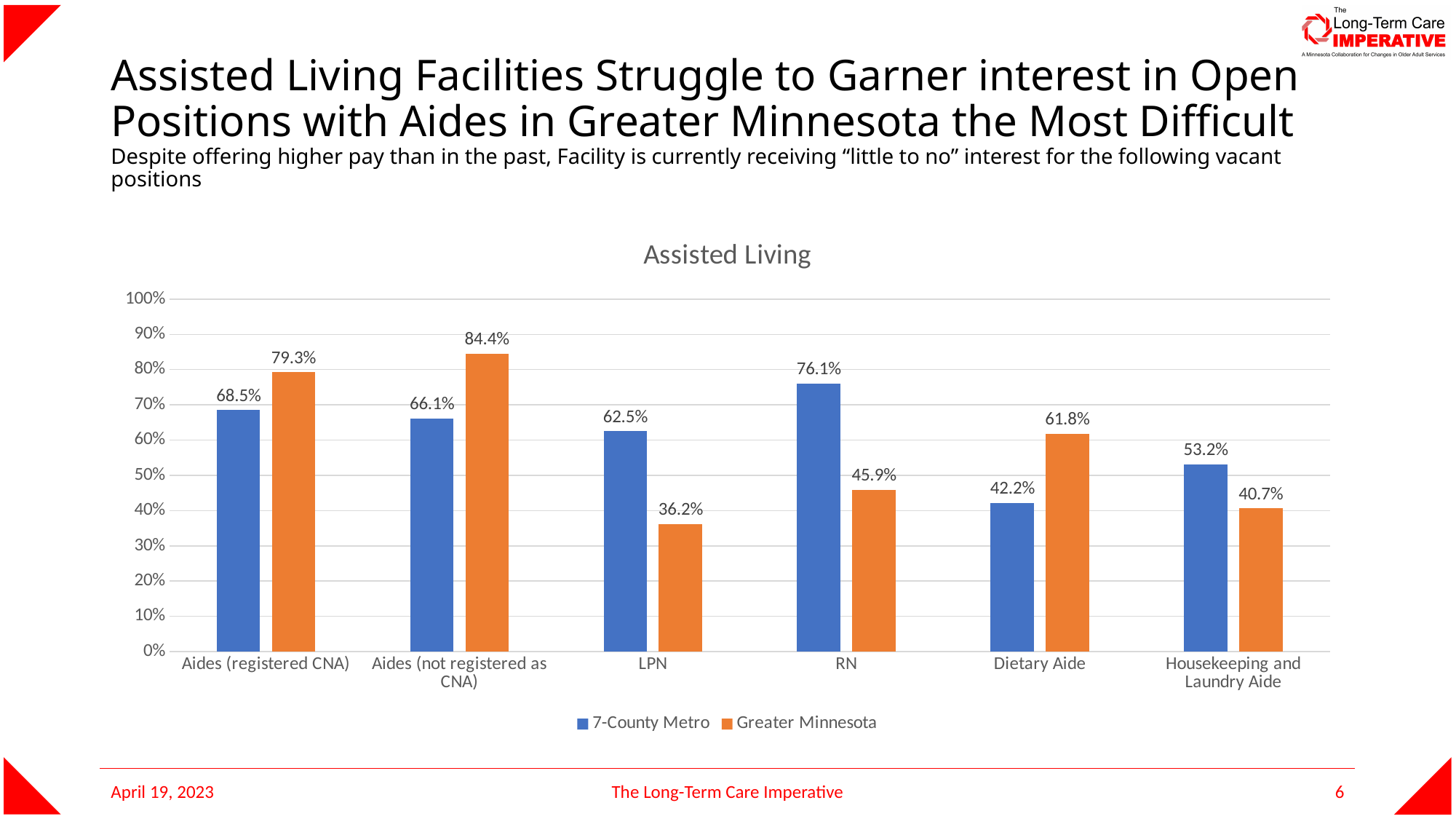
What is the Greater Minnesota value for Housekeeping and Laundry Aide? 40.7% Which category has the highest Greater Minnesota value? Aides (not registered as CNA) Which category has the lowest 7-County Metro value? Dietary Aide How many series does the legend list? 2 What is the title of the chart? Assisted Living How many position categories are shown on the x axis? 6 What is the difference between the Greater Minnesota and 7-County Metro values for RN? 30.2% What is the 7-County Metro value for LPN? 62.5% For Dietary Aide, which series has the larger value, 7-County Metro or Greater Minnesota? Greater Minnesota What kind of chart is shown on the slide? Bar chart Is the Greater Minnesota value for LPN greater or less than 40%? less What is the Greater Minnesota value for Aides (not registered as CNA)? 84.4%